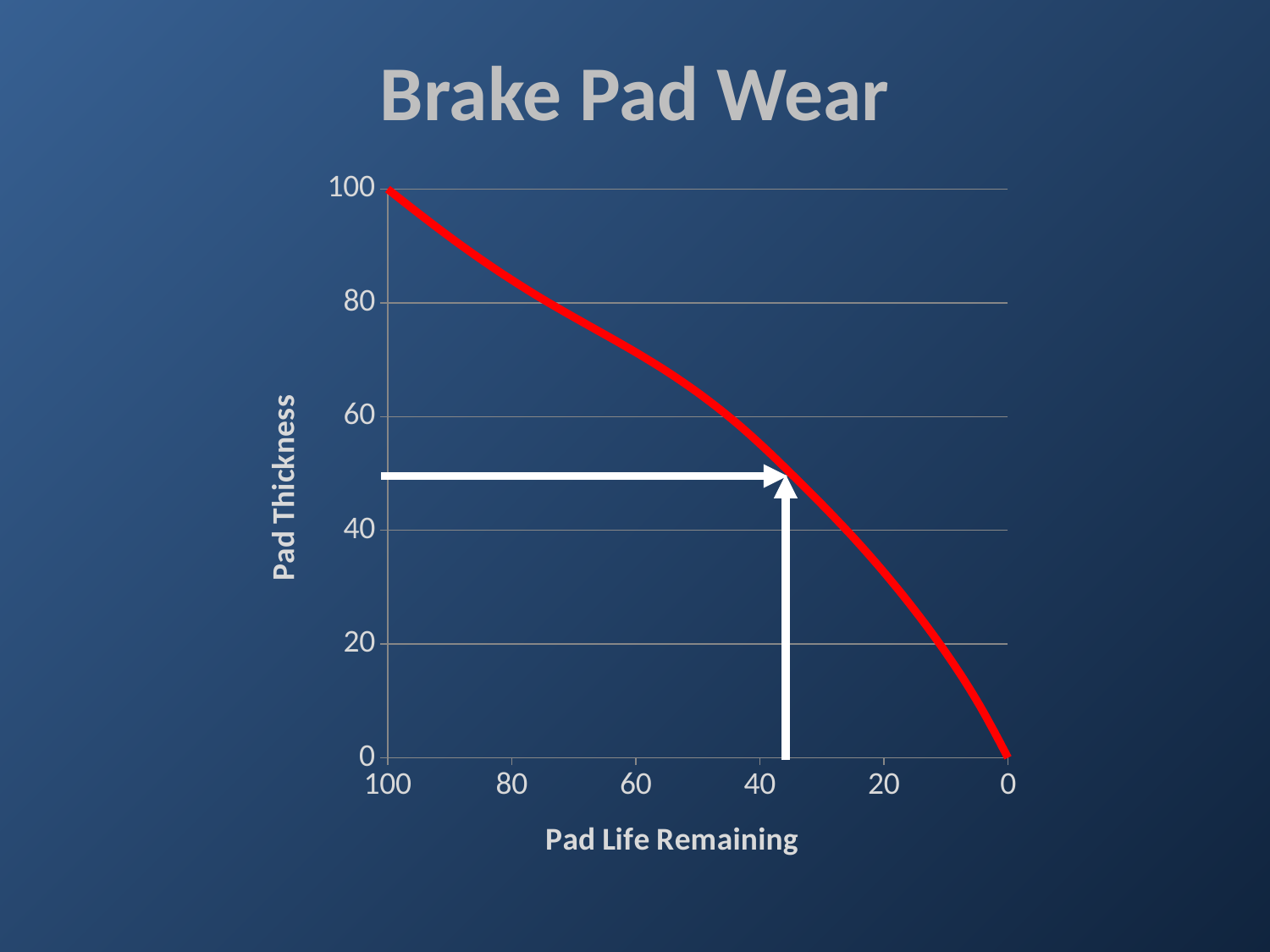
What is the label of the vertical axis? Pad Thickness What kind of chart is shown on the slide? Line chart Is the pad thickness at a pad life remaining of 20 greater or less than 20? greater What is the title of the chart? Brake Pad Wear What is the pad thickness when pad life remaining is 0? 0 Is the pad thickness at a pad life remaining of 20 greater or less than 40? less What is the pad thickness when pad life remaining is 100? 100 Is the pad thickness at a pad life remaining of 60 greater or less than 80? less Do the pad thickness values rise or fall moving from left to right along the x axis? Fall At which pad life remaining value is the pad thickness highest? 100